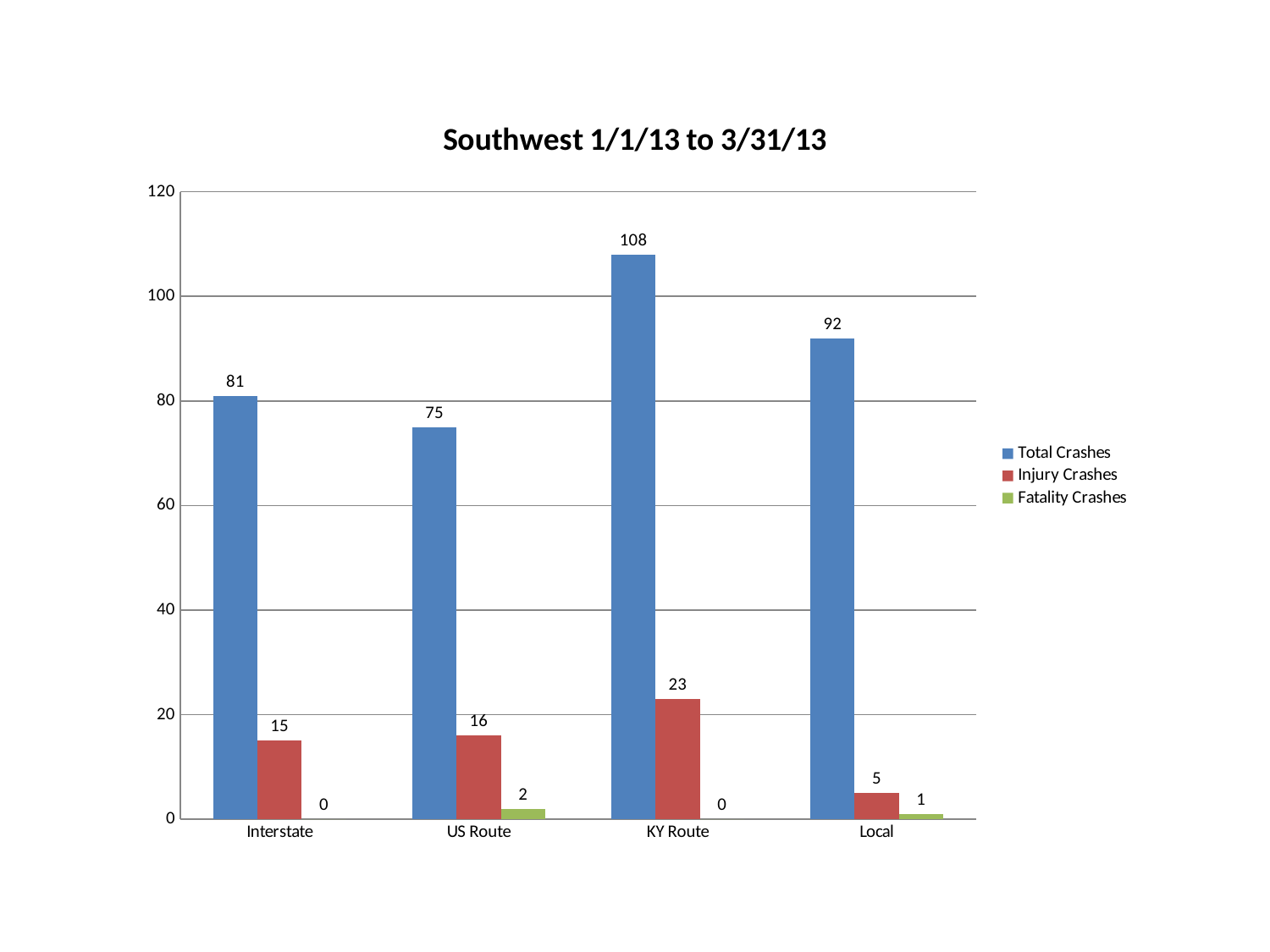
What is the value of Injury Crashes for US Route? 16 Which category has the highest Total Crashes? KY Route What is the title of the chart? Southwest 1/1/13 to 3/31/13 What kind of chart is shown on the slide? bar chart Which is larger, Injury Crashes for Interstate or Injury Crashes for US Route? US Route What is the difference between Total Crashes for KY Route and Local? 16 Is the value of Total Crashes for Local greater or less than 100? less How many series does the legend list? 3 Which category has the lowest Total Crashes? US Route How many categories are shown on the x axis? 4 What is the value of Total Crashes for KY Route? 108 What is the value of Fatality Crashes for Local? 1